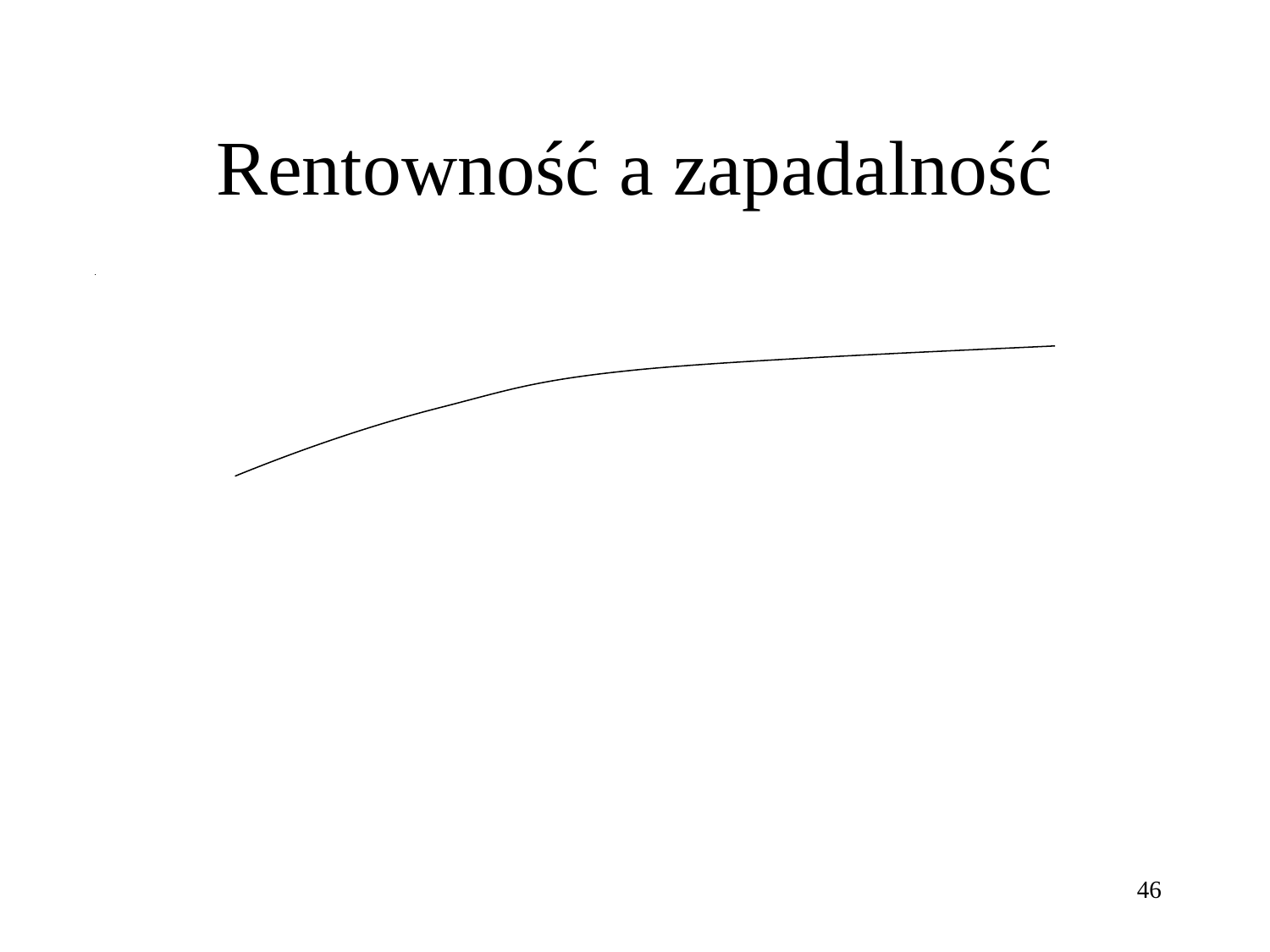
Does the chart show a legend? No How many lines are plotted on the chart? 1 What is the title of the slide containing the chart? Rentowność a zapadalność What kind of chart is shown on the slide? line chart Does the plotted line rise or fall from left to right? rises